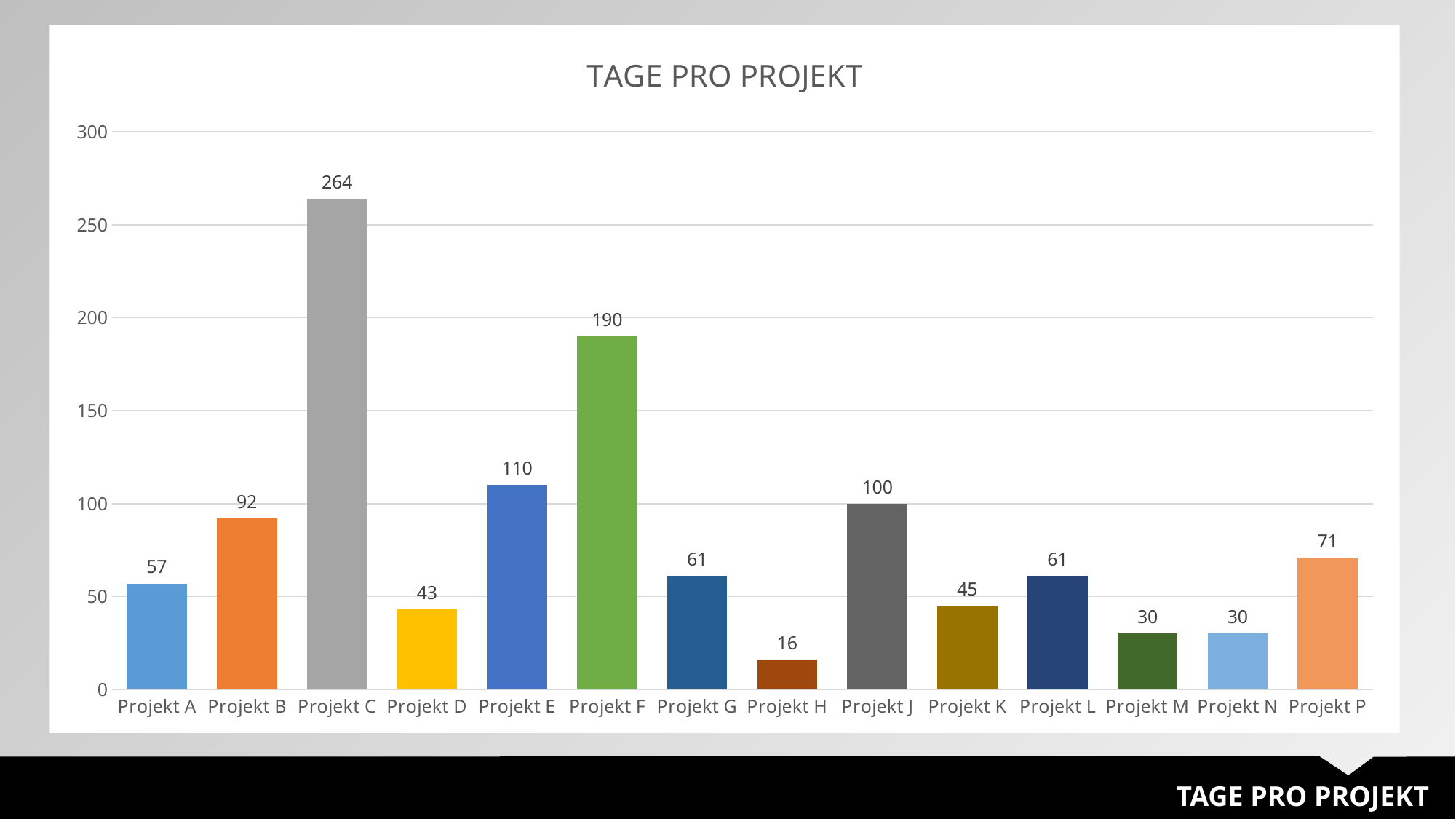
What is the difference between the values for Projekt C and Projekt F? 74 Which project has the lowest value? Projekt H What kind of chart is shown on the slide? bar chart What is the value for Projekt K? 45 What is the difference between the values for Projekt E and Projekt J? 10 Which is larger, the value for Projekt B or the value for Projekt P? Projekt B Which project has the highest value? Projekt C Is the value for Projekt F greater or less than 150? greater What is the value for Projekt H? 16 What is the value for Projekt C? 264 What is the title of the chart? TAGE PRO PROJEKT How many projects are shown on the chart? 14